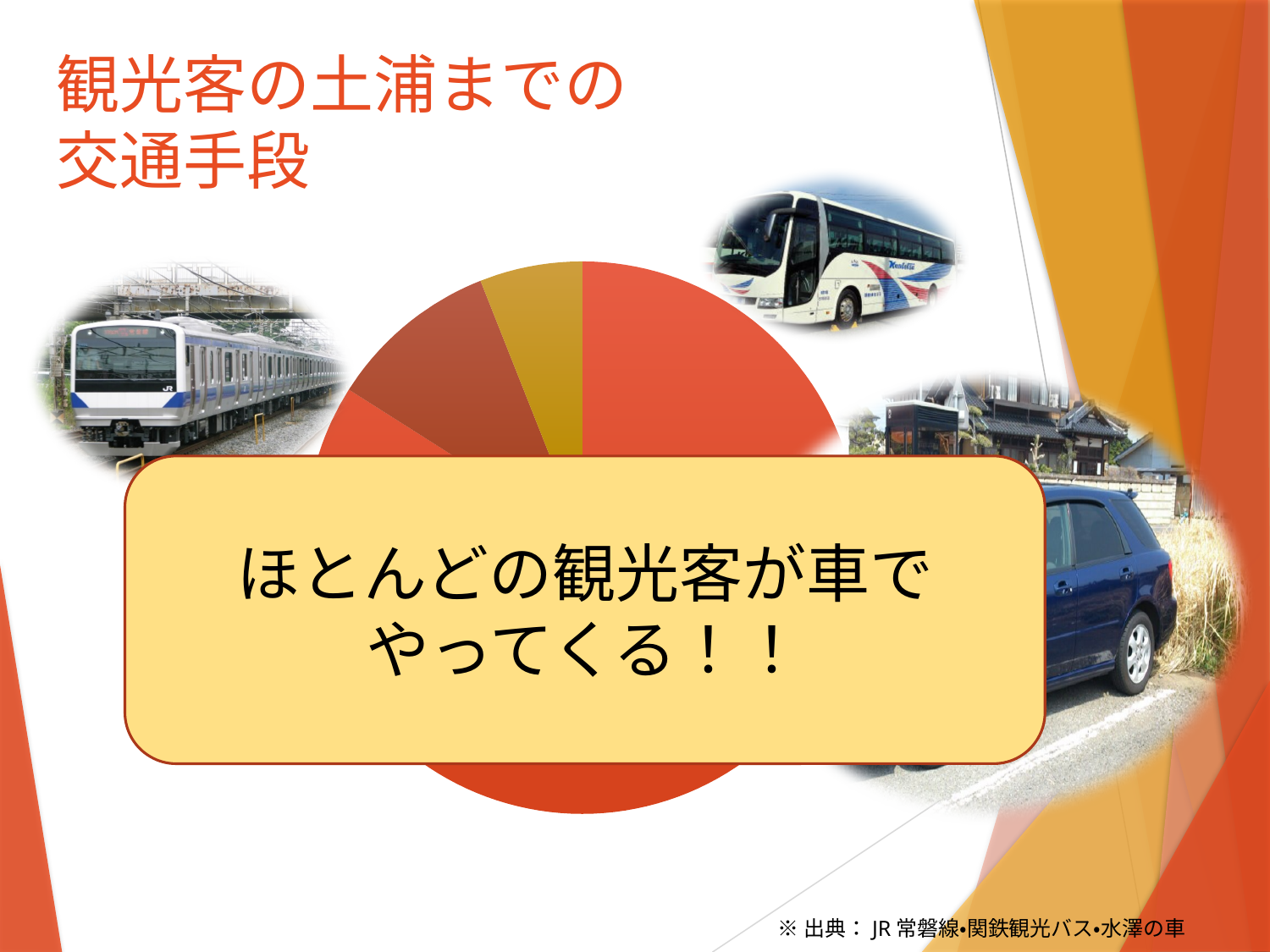
Does the pie chart display a legend? No Which is larger in the pie chart, the red slice or the gold slice? red Which colour slice is the smallest in the pie chart? gold Which colour slice is the largest in the pie chart? red Does the largest slice of the pie chart take up more or less than half of the pie? more What is the title of the slide containing the pie chart? 観光客の土浦までの交通手段 What kind of chart is shown on the slide? pie chart How many slices does the pie chart have? 3 Which is larger in the pie chart, the orange slice or the gold slice? orange